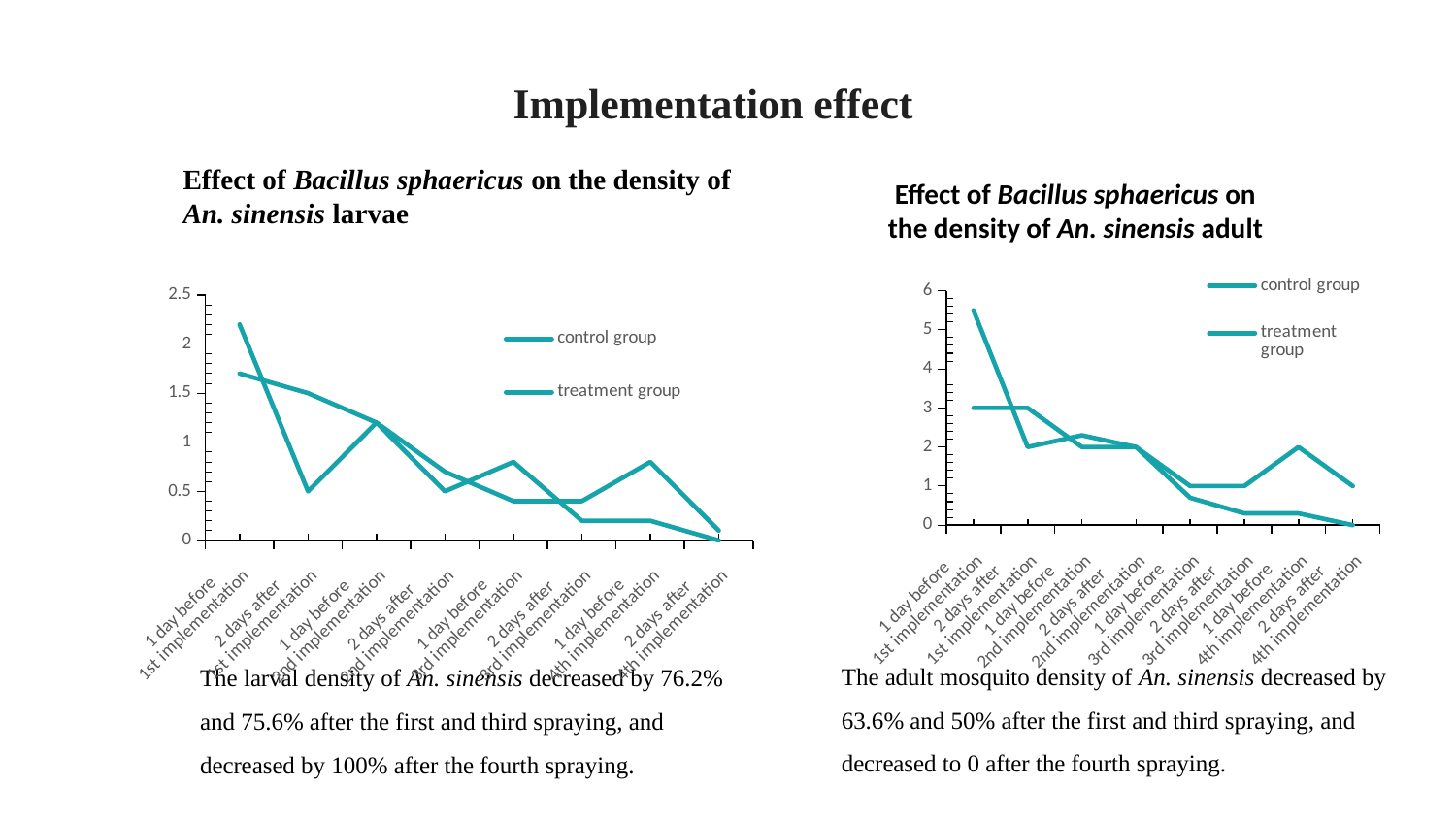
How many time points are plotted along the x axis of the left chart (larvae)? 8 On the left chart (larvae), do the plotted values generally rise or fall from left to right along the x axis? fall On the right chart (adult), is the highest plotted value greater or less than 5? greater On the left chart (larvae), is the highest plotted value greater or less than 2? greater What is the maximum value shown on the y axis of the right chart (adult)? 6 What kind of chart is the left chart, 'Effect of Bacillus sphaericus on the density of An. sinensis larvae'? line chart How many time points are plotted along the x axis of the right chart (adult)? 8 How many series does the legend of the right chart (adult) list? 2 How many series does the legend of the left chart (larvae) list? 2 What are the two series named in the legend of the right chart (adult)? control group and treatment group What kind of chart is the right chart, 'Effect of Bacillus sphaericus on the density of An. sinensis adult'? line chart On the right chart (adult), do the plotted values generally rise or fall from left to right along the x axis? fall